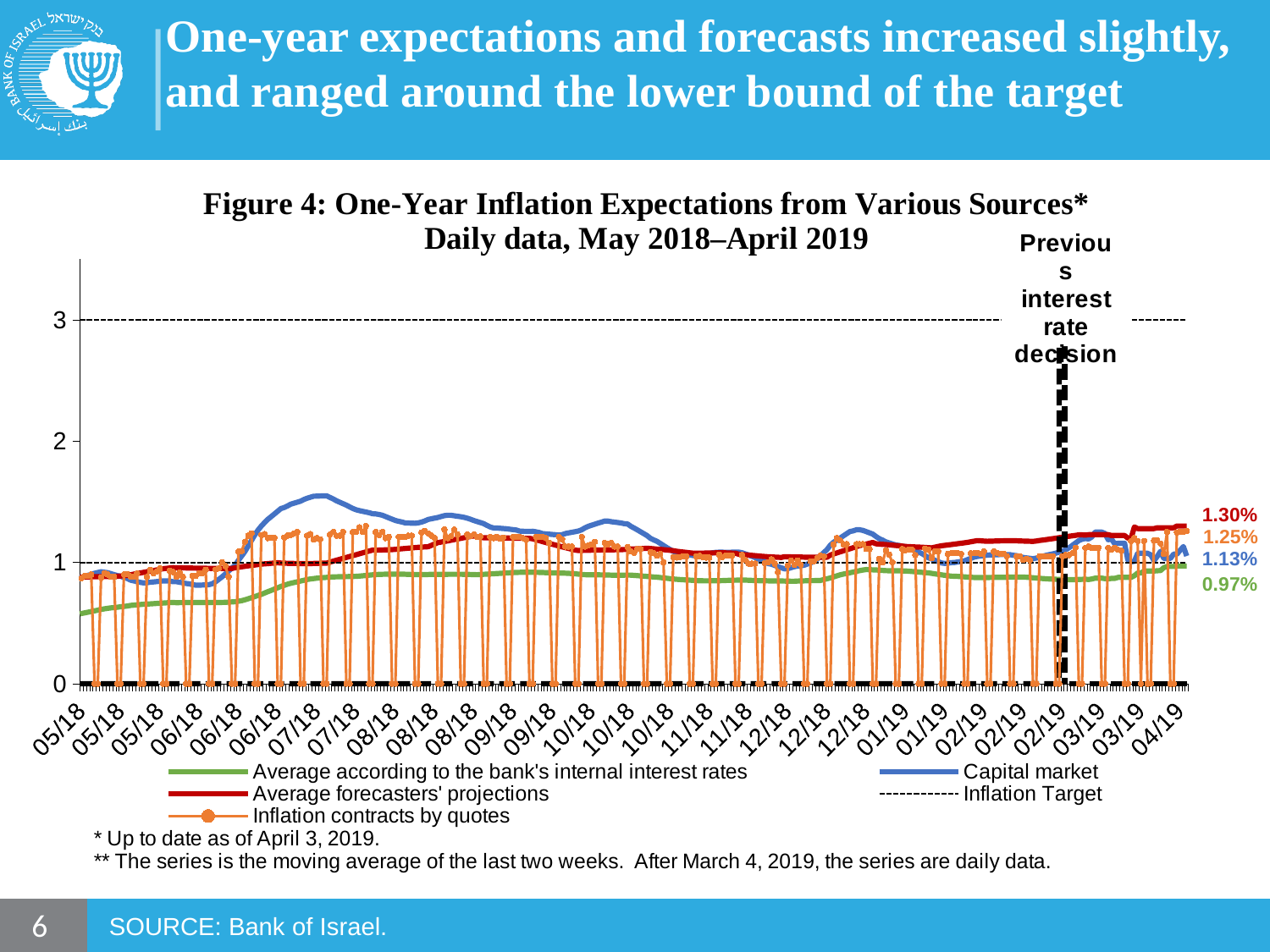
Which series has the highest end-of-period value labelled on the chart? Average forecasters' projections What is the title of the chart on the slide? Figure 4: One-Year Inflation Expectations from Various Sources* How many series does the legend of Figure 4 list? 5 Is the value of the green line (bank's internal interest rates) at the start of the period in May 2018 greater or less than 1? less What is the difference between the labelled end values of the average forecasters' projections (1.30%) and the capital market series (1.13%)? 0.17% Which series has the lowest end-of-period value labelled on the chart? Average according to the bank's internal interest rates What is the latest value shown for the inflation contracts by quotes series (orange line)? 1.25% Which is larger at the end of the period: the inflation contracts by quotes value or the capital market value? Inflation contracts by quotes What kind of chart is shown in Figure 4? line chart What is the latest value shown for the capital market series (blue line)? 1.13% What is the latest value shown for the average according to the bank's internal interest rates series (green line)? 0.97% What is the latest value shown for the average forecasters' projections series (red line)? 1.30%